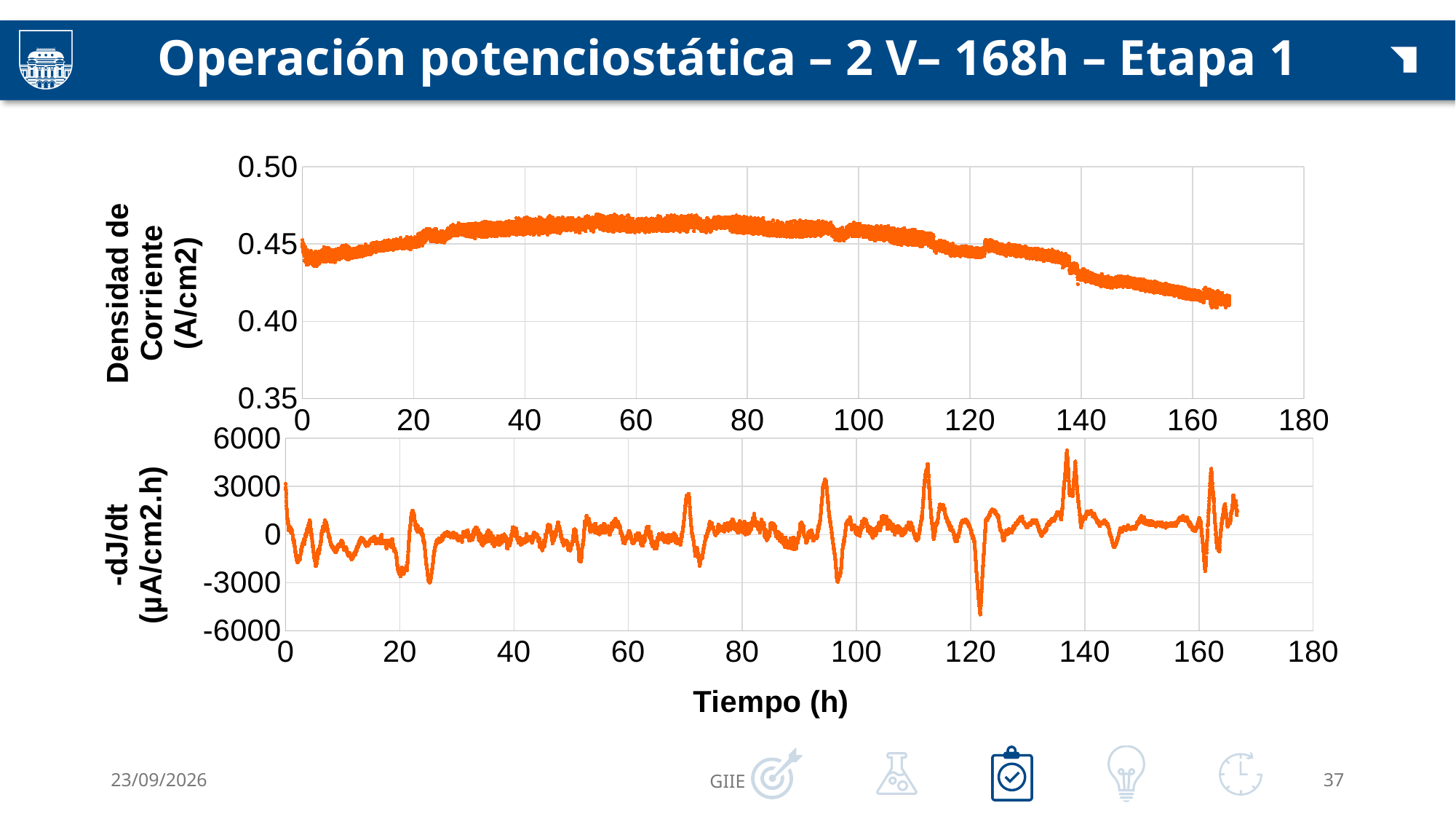
In the top chart, does the current density rise or fall between 100 h and 160 h? fall In the top chart, is the current density at 60 h greater or less than 0.45 A/cm2? greater In the bottom chart, is the lowest spike (near 122 h) greater or less than -3000 µA/cm2.h? less In the top chart, is the current density at 160 h greater or less than 0.45 A/cm2? less What is the x-axis label shared by both charts? Tiempo (h) What kind of chart is the top chart (Densidad de Corriente vs Tiempo)? line chart What is the y-axis label of the bottom chart? -dJ/dt (µA/cm2.h) In the top chart, does the current density rise or fall between 0 h and 40 h? rise What kind of chart is the bottom chart (-dJ/dt vs Tiempo)? line chart